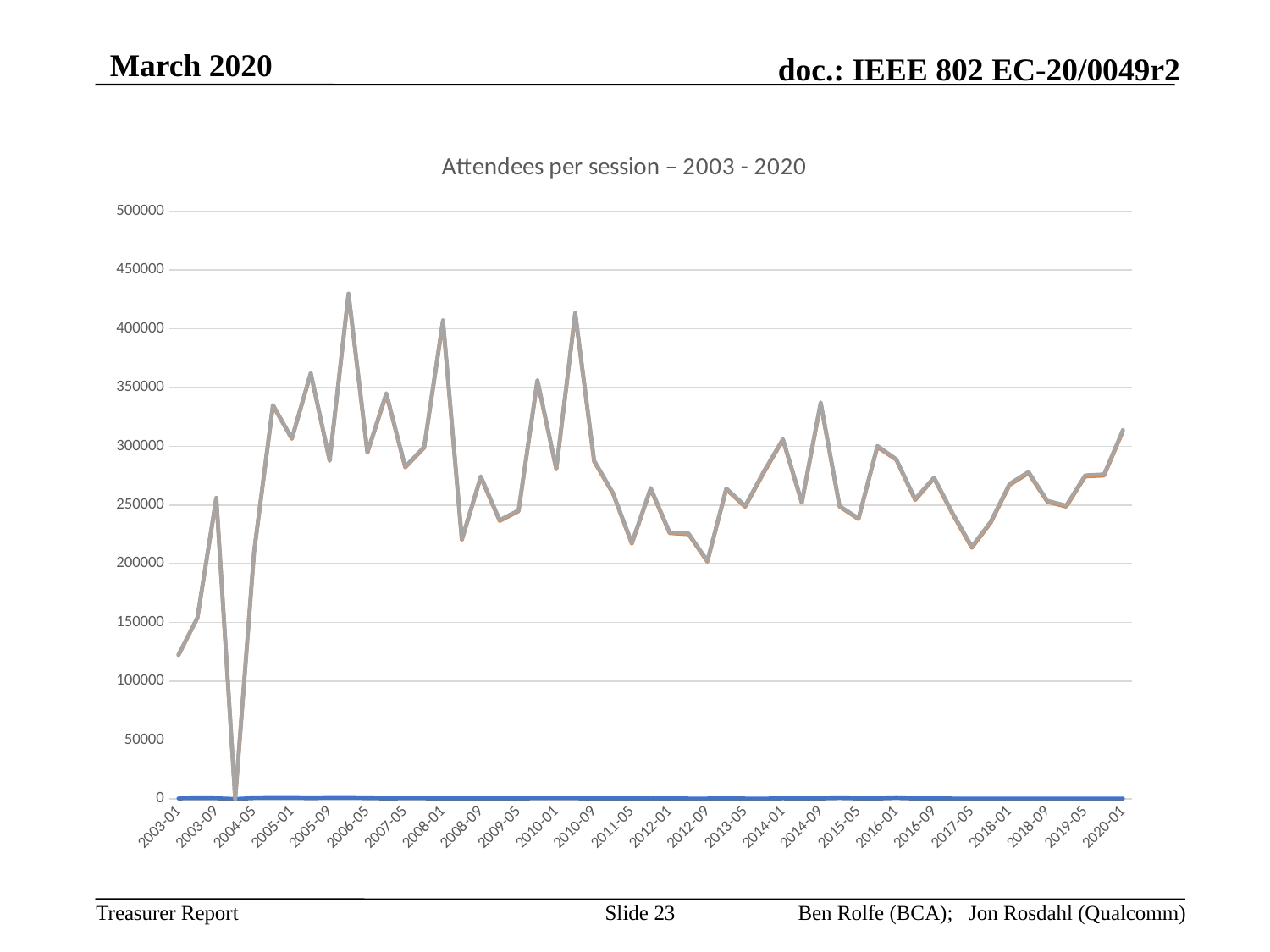
Is the value for 2003-01 greater or less than 150000? less Which is larger, the value for 2006-05 or the value for 2012-09? 2006-05 What kind of chart is shown on the slide? line chart What is the highest value shown on the vertical axis of the chart? 500000 Do the values generally rise or fall between 2017-05 and 2020-01? rise What is the title of the chart? Attendees per session – 2003 - 2020 Is the value for 2014-09 greater or less than 300000? greater Is the value for 2012-09 greater or less than 250000? less